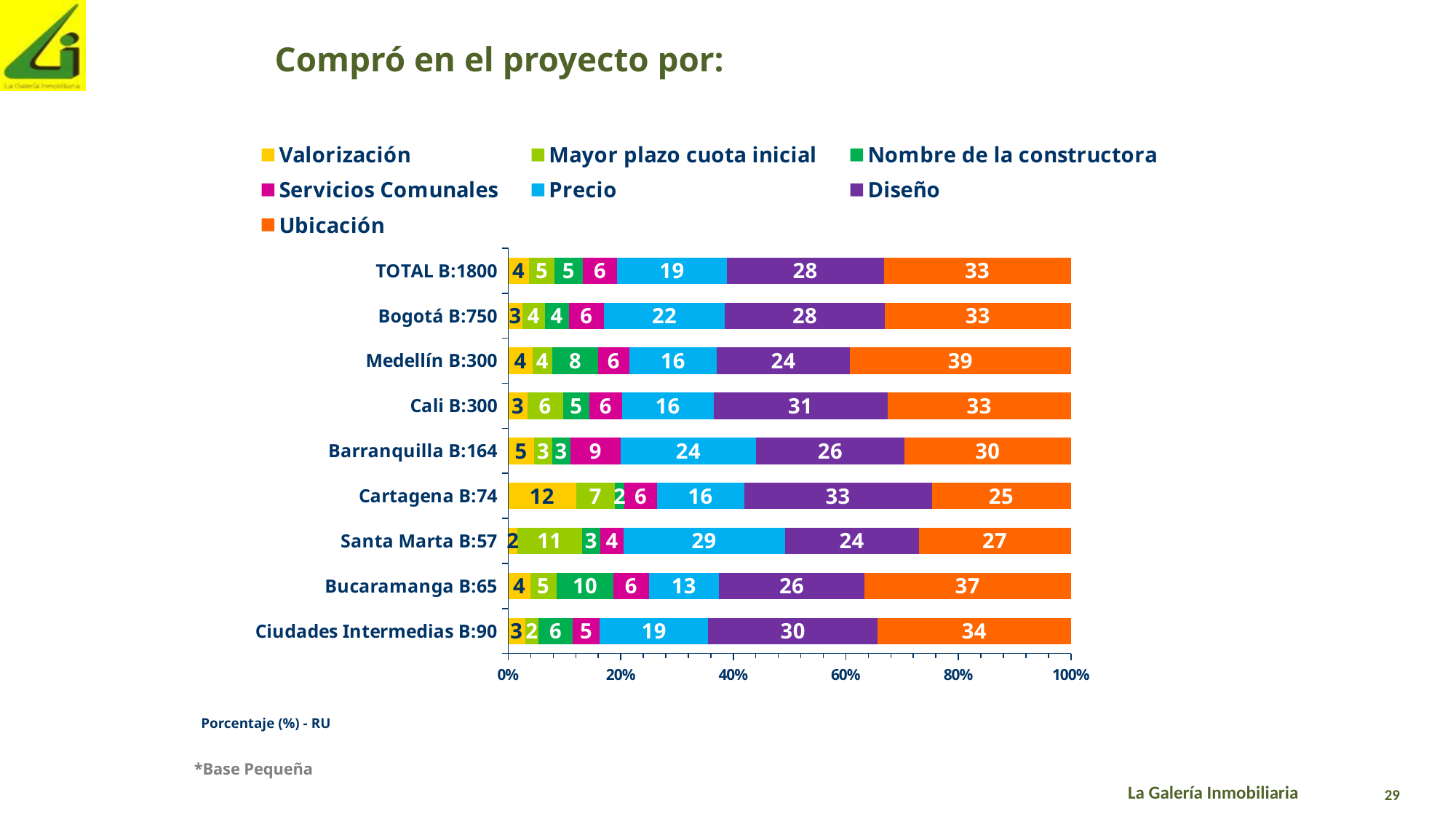
Which category has the lowest Precio value? Bucaramanga B:65 Which category has the highest Ubicación value? Medellín B:300 How many categories (bars) are shown on the chart? 9 What is the Precio value for Santa Marta B:57? 29 How many series does the legend list? 7 What type of chart is shown on the slide? Stacked bar chart What is the Diseño value for TOTAL B:1800? 28 Which legend entry is shown in orange? Ubicación What is the difference between the Ubicación values for Bucaramanga B:65 and Cartagena B:74? 12 What is the Ubicación value for Medellín B:300? 39 Which is larger, the Diseño value for Cali B:300 or for Barranquilla B:164? Cali B:300 What is the Valorización value for Cartagena B:74? 12